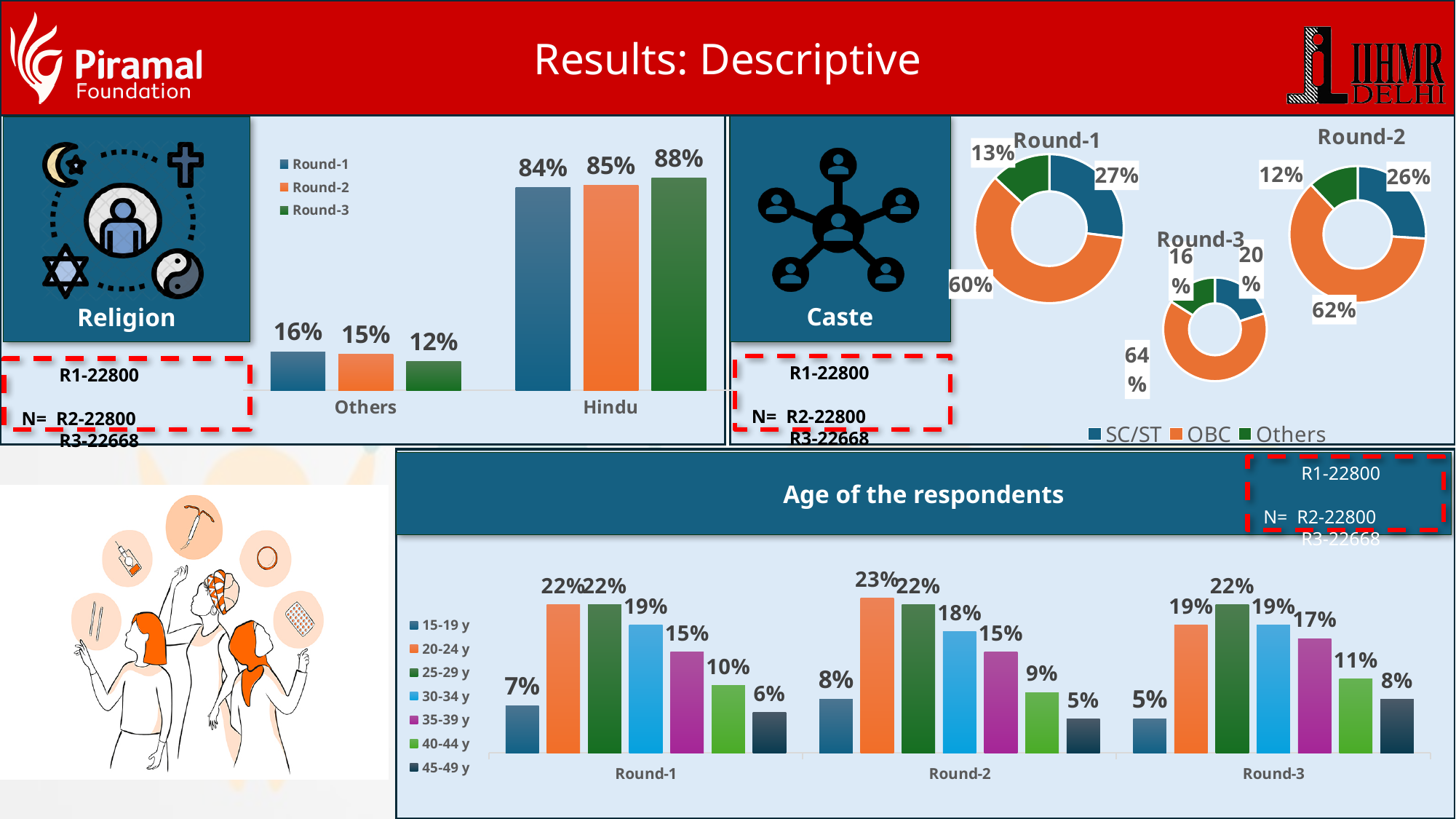
In the Religion chart, what is the value for Others in Round-1? 16% In the Caste Round-3 donut chart, what share is SC/ST? 20% What kind of chart is the Religion chart? bar chart In the Religion chart, what is the value for Hindu in Round-3? 88% In the Age of the respondents chart, what is the value for 20-24 y in Round-2? 23% How many series does the legend of the Religion chart list? 3 In the Religion chart, what is the difference between the Hindu values for Round-3 and Round-1? 4% How many series does the legend of the Age of the respondents chart list? 7 In the Age of the respondents chart, which age group has the lowest value in Round-3? 15-19 y In the Age of the respondents chart, which is larger in Round-1: 30-34 y or 35-39 y? 30-34 y In the Caste Round-1 donut chart, what share is OBC? 60% In the Caste Round-2 donut chart, which category has the smallest share? Others